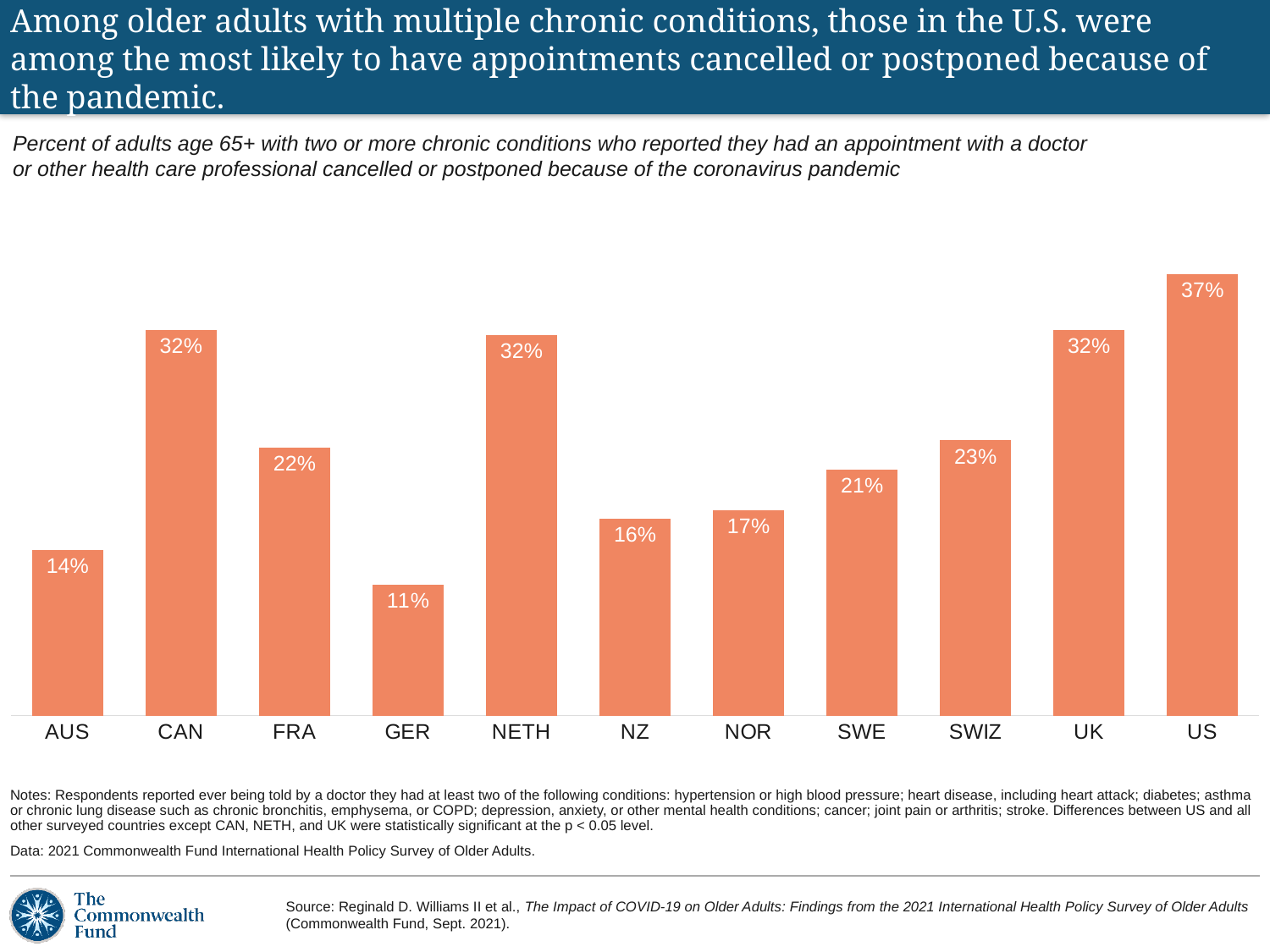
How many countries share the value 32%? 3 What kind of chart is shown on the slide? Bar chart What is the value for the US? 37% Which country has the lowest value? GER Which is larger, the value for SWIZ or the value for NOR? SWIZ What is the value for SWE? 21% How many countries are shown in the chart? 11 What is the difference between the values for FRA and NZ? 6 percentage points What colour are the bars in the chart? Orange What is the difference between the values for the US and AUS? 23 percentage points What is the value for GER? 11% Which country has the highest value? US